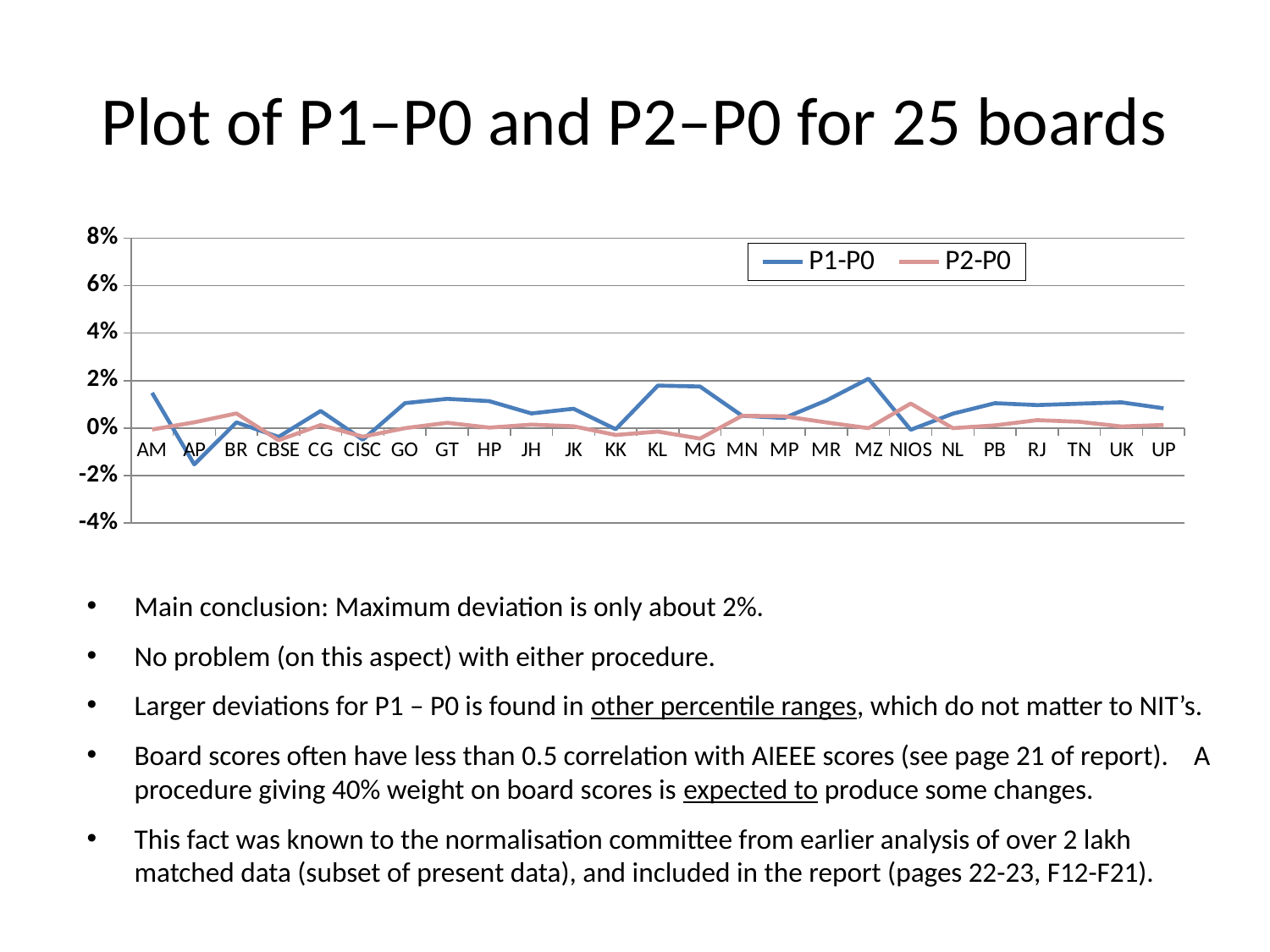
At MZ, which series has the larger value, P1-P0 or P2-P0? P1-P0 What kind of chart is shown on the slide? line chart Which board has the lowest P1-P0 value? AP What is the title of the chart on the slide? Plot of P1–P0 and P2–P0 for 25 boards Which board has the highest P2-P0 value? NIOS How many series does the legend list? 2 Is the P1-P0 value for KL greater or less than 0%? greater Which board has the highest P1-P0 value? MZ At AP, which series has the larger value, P1-P0 or P2-P0? P2-P0 Is the P1-P0 value for AP greater or less than 0%? less Is the P1-P0 value for MZ greater or less than 4%? less How many boards (categories) are plotted along the x axis? 25